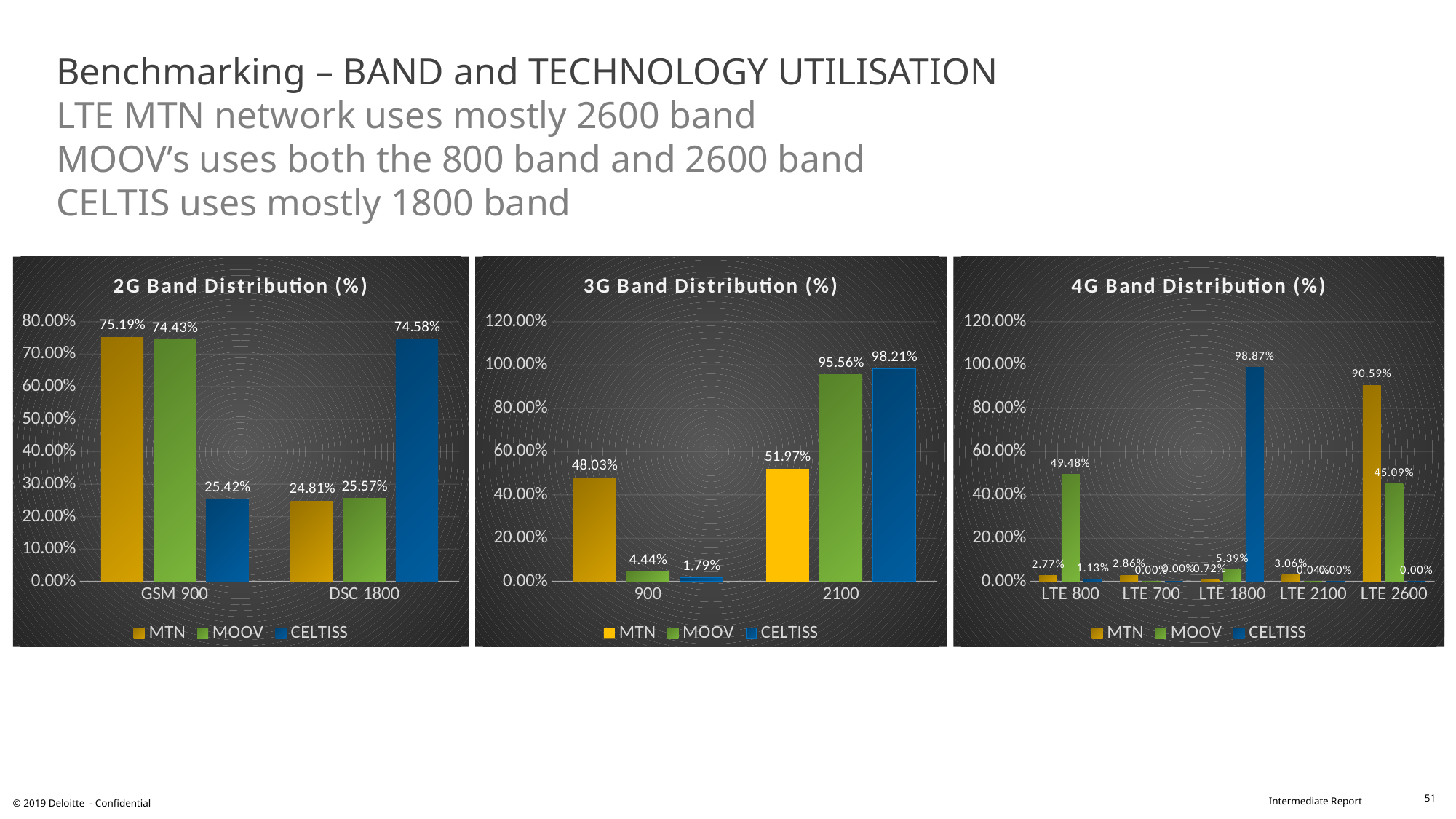
In the 2G Band Distribution (%) chart, what is the value for MTN at GSM 900? 75.19% In the 3G Band Distribution (%) chart, what is the value for MTN at 900? 48.03% In the 4G Band Distribution (%) chart, what is the value for CELTISS at LTE 1800? 98.87% In the 4G Band Distribution (%) chart, how many band categories are shown on the x axis? 5 In the 3G Band Distribution (%) chart, is the MOOV value at 2100 greater or less than 80.00%? greater How many series does the legend of the 2G Band Distribution (%) chart list? 3 In the 2G Band Distribution (%) chart, what is the value for CELTISS at DSC 1800? 74.58% In the 3G Band Distribution (%) chart, which series has the lowest value at 900? CELTISS In the 2G Band Distribution (%) chart, what is the difference between the MOOV values at GSM 900 and DSC 1800? 48.86% What type of chart is the 3G Band Distribution (%) chart? Bar chart In the 3G Band Distribution (%) chart, which series has the highest value at 2100? CELTISS In the 4G Band Distribution (%) chart, which is larger at LTE 2600: MTN or MOOV? MTN